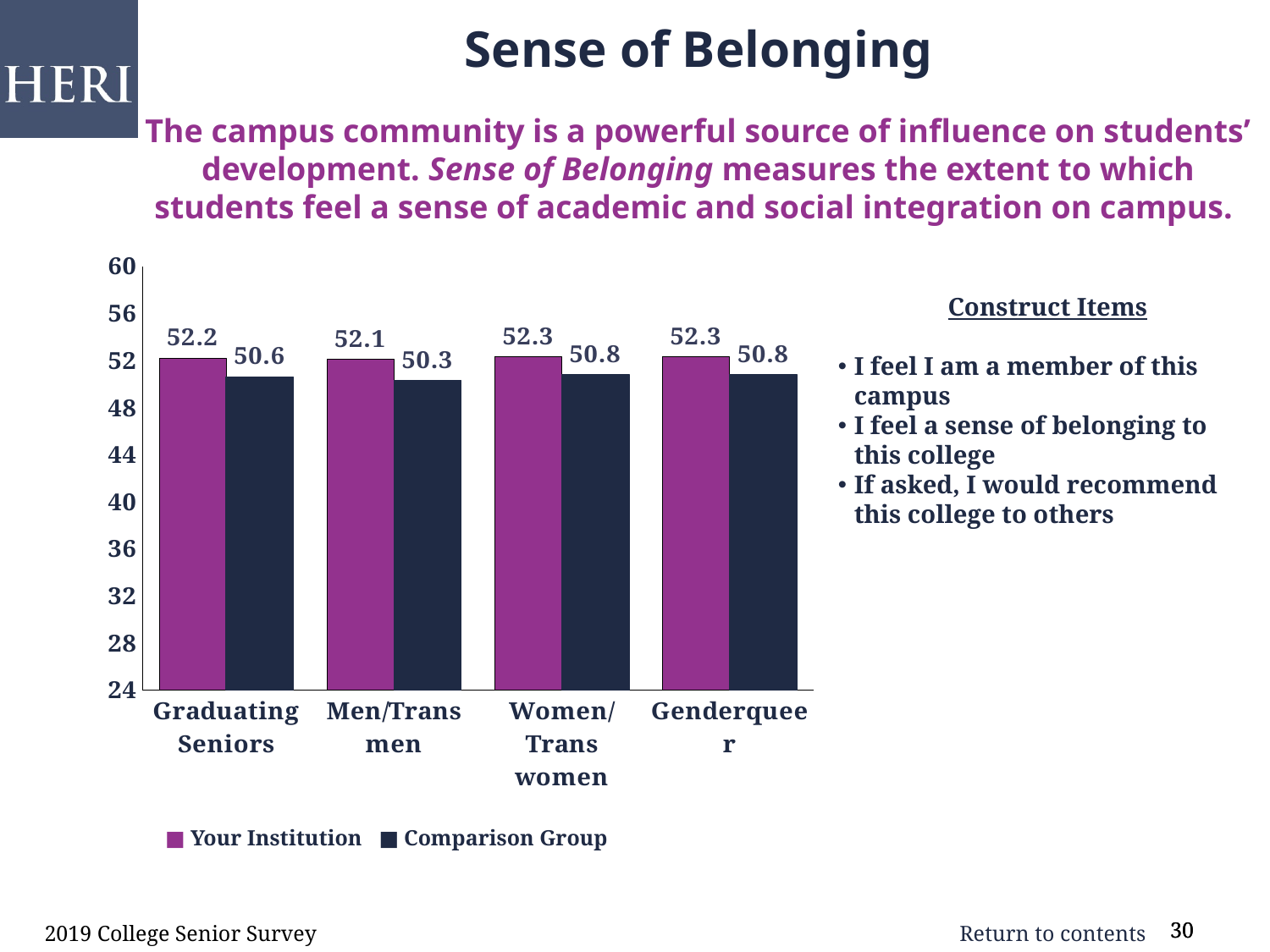
What is the Comparison Group value for Men/Trans men? 50.3 What is the Your Institution value for Graduating Seniors? 52.2 What is the Your Institution value for Women/Trans women? 52.3 Which category has the lowest Comparison Group value? Men/Trans men What is the Comparison Group value for Genderqueer? 50.8 What is the difference between the Your Institution and Comparison Group values for Graduating Seniors? 1.6 How many series does the legend list? 2 What is the difference between the Your Institution and Comparison Group values for Men/Trans men? 1.8 For Women/Trans women, which is larger: the Your Institution value or the Comparison Group value? Your Institution What kind of chart is shown on the slide? Bar chart Is the Comparison Group value for Graduating Seniors greater or less than 52? less How many categories are shown on the x axis? 4